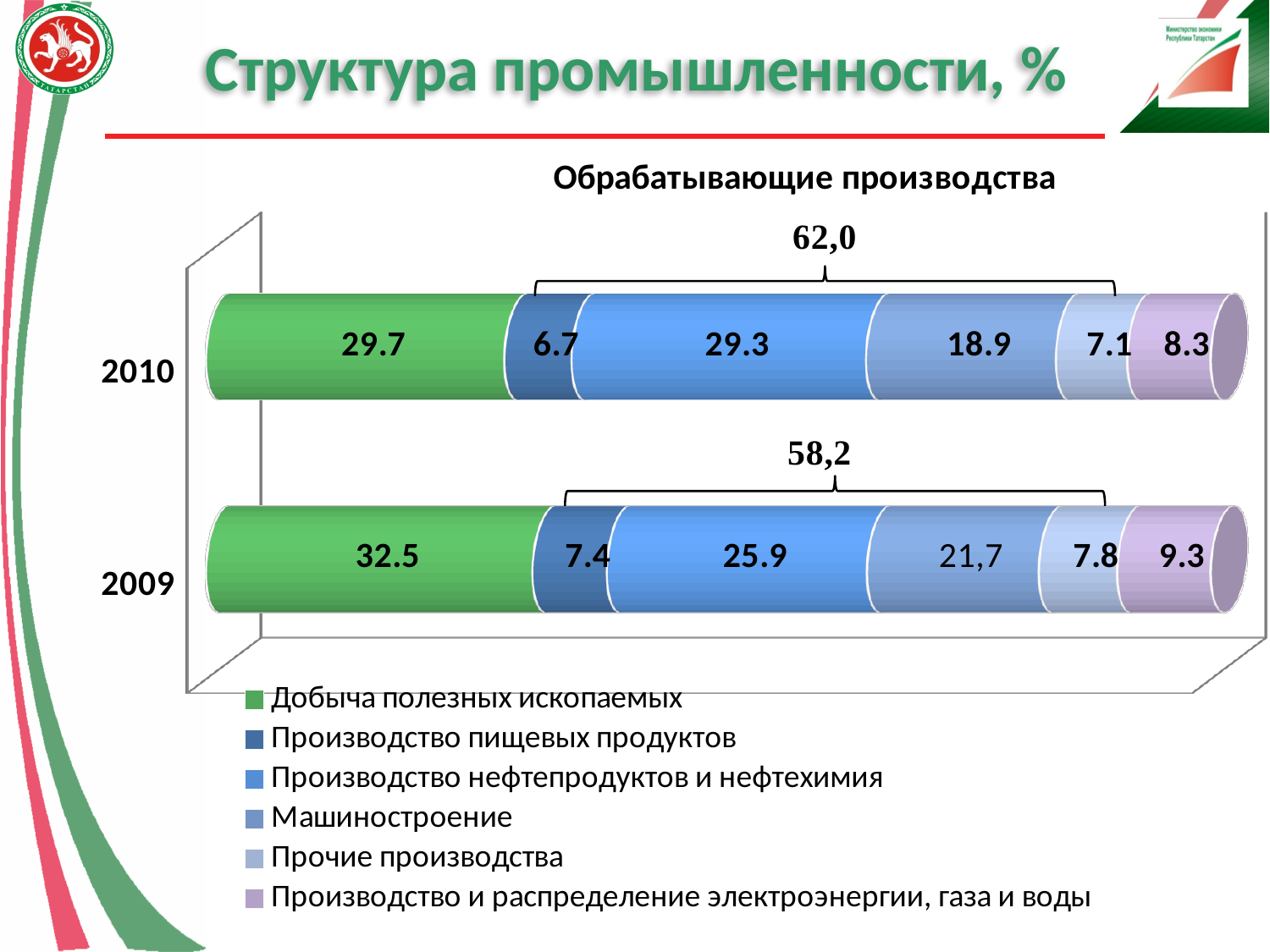
What is the value for Добыча полезных ископаемых in 2010? 29.7 What is the value for Производство и распределение электроэнергии, газа и воды in 2009? 9.3 Which is larger: Производство нефтепродуктов и нефтехимия in 2010 or in 2009? 2010 What is the difference between the Добыча полезных ископаемых values for 2009 and 2010? 2.8 What total is shown by the bracket labelled Обрабатывающие производства for 2010? 62,0 How many series does the legend list? 6 Which series has the lowest value in the 2010 bar? Производство пищевых продуктов What is the value for Производство нефтепродуктов и нефтехимия in 2009? 25.9 What type of chart is shown on the slide? Stacked bar chart What is the value for Машиностроение in 2010? 18.9 Which series has the highest value in the 2009 bar? Добыча полезных ископаемых How many categories (years) are plotted on the chart? 2